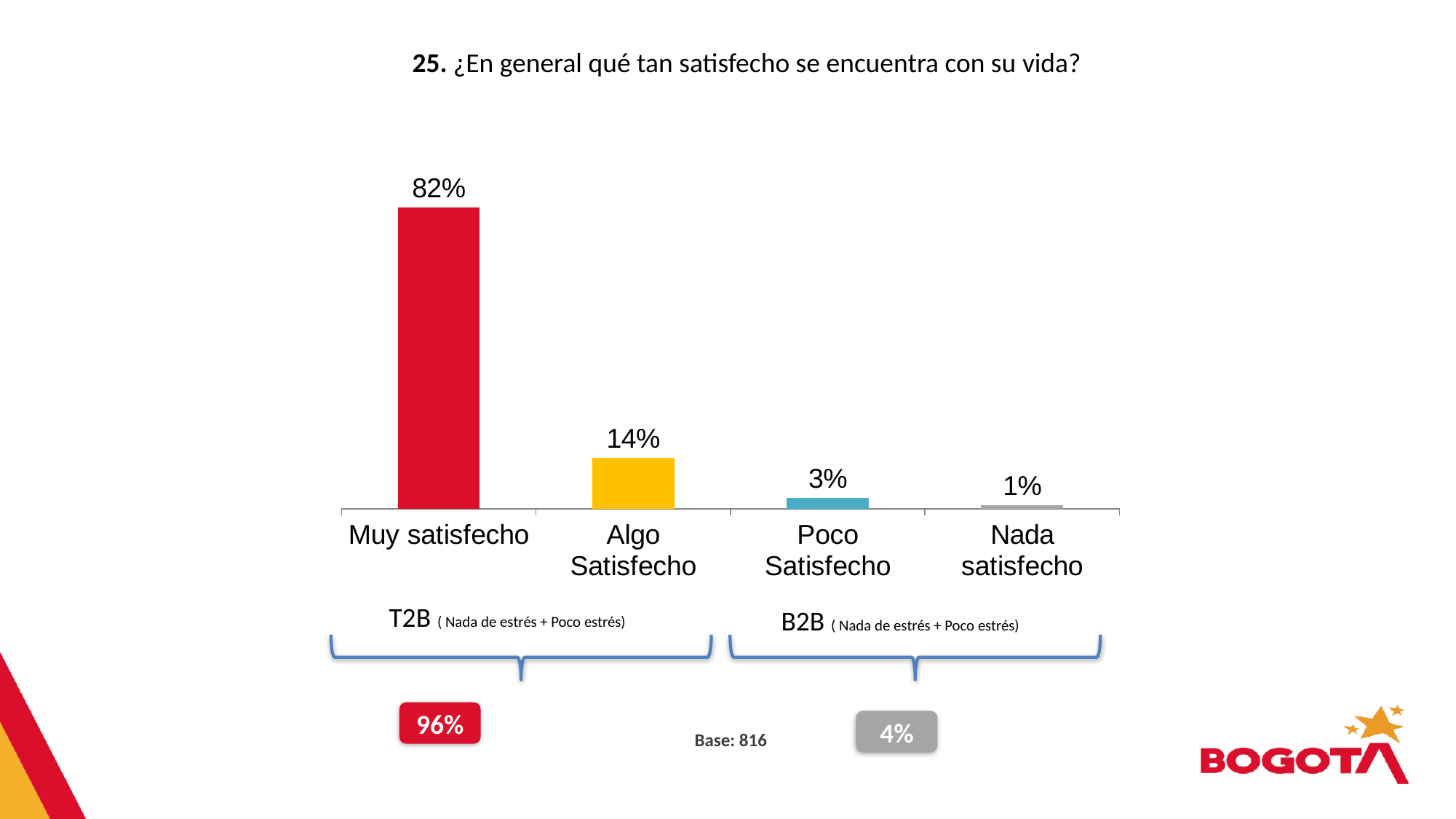
How many categories are shown in the chart? 4 Which category has the highest value? Muy satisfecho Which is larger, the value for Algo Satisfecho or the value for Poco Satisfecho? Algo Satisfecho What is the difference between the values for Muy satisfecho and Algo Satisfecho? 68% What is the value for Algo Satisfecho? 14% What kind of chart is shown on the slide? Bar chart Which category has the lowest value? Nada satisfecho What is the value for Muy satisfecho? 82% What is the value for Nada satisfecho? 1% Do the values rise or fall from left to right across the categories? Fall What is the T2B value shown below the chart? 96% What is the value for Poco Satisfecho? 3%